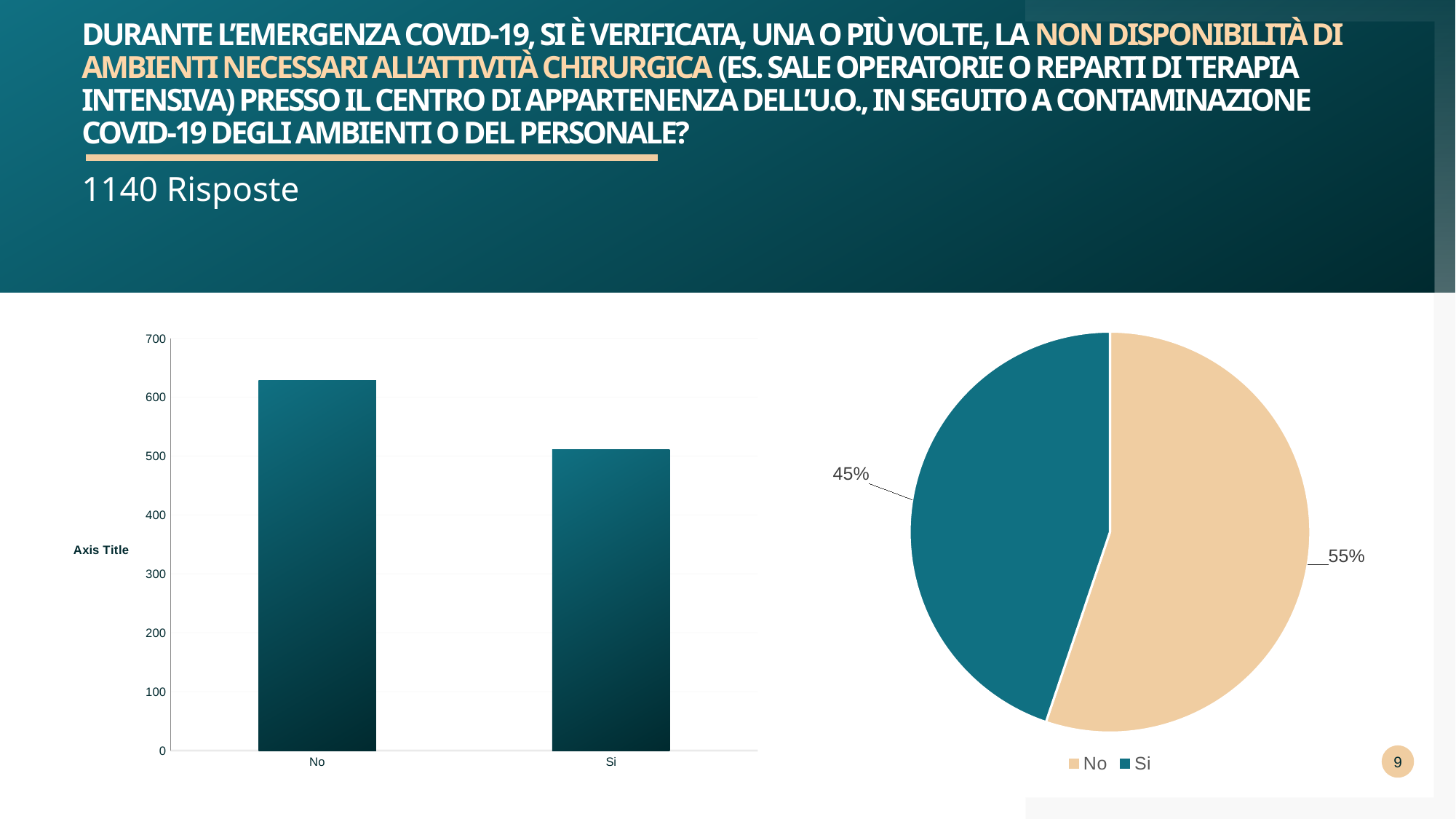
In the pie chart on the right, what share of the pie does Si represent? 45% What kind of chart is the chart on the right of the slide? pie chart In the pie chart on the right, what share of the pie does No represent? 55% In the bar chart on the left, which category has the highest bar? No In the bar chart on the left, is the value for Si greater or less than 600? less In the bar chart on the left, how many categories are shown on the x axis? 2 What kind of chart is the chart on the left of the slide? bar chart In the bar chart on the left, is the value for No greater or less than 600? greater In the bar chart on the left, which category has the lowest bar? Si In the pie chart on the right, how many entries does the legend list? 2 In the pie chart on the right, what is the difference in percentage points between the No and Si slices? 10 percentage points